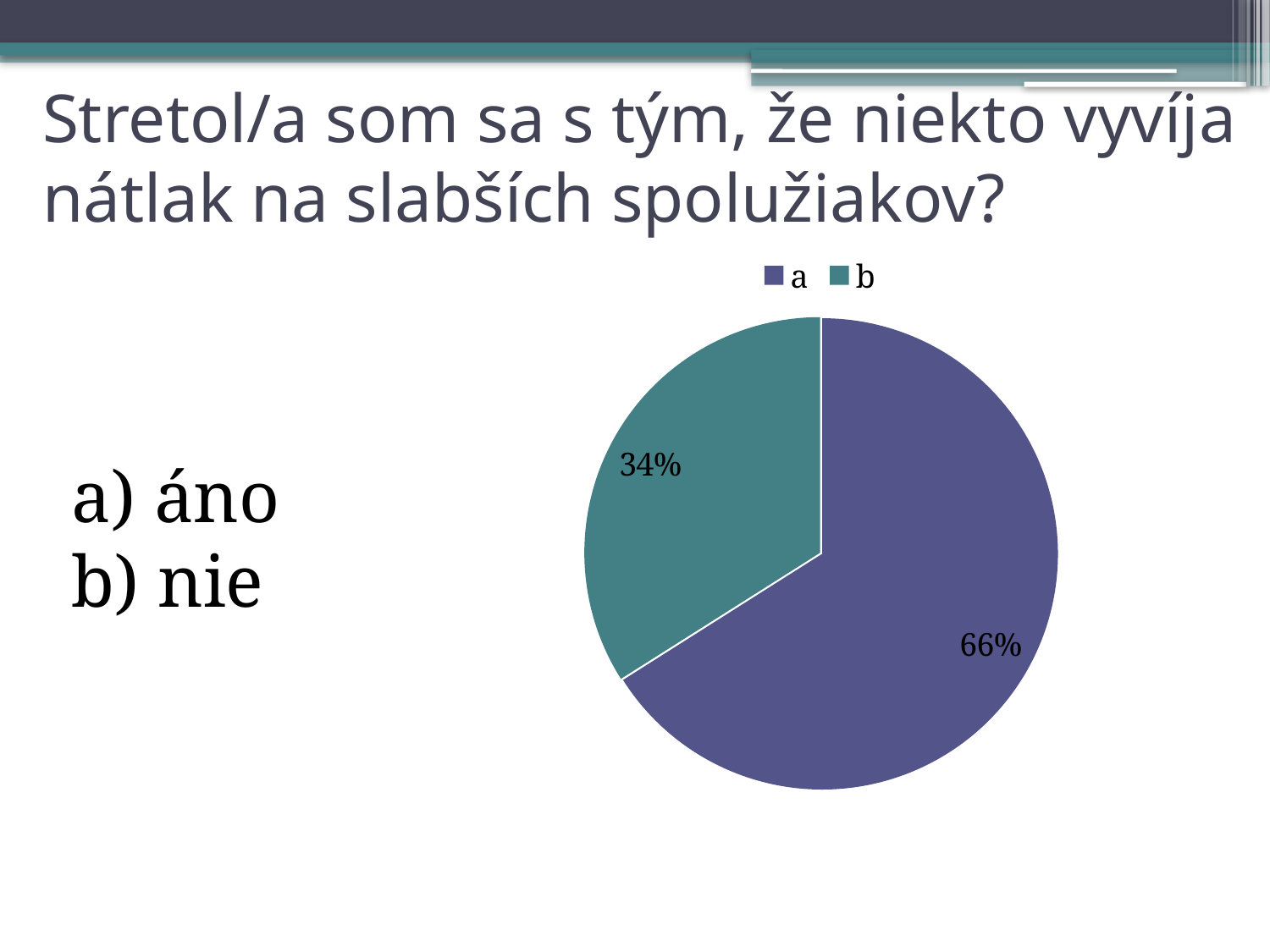
Which slice is the smallest? b Which is larger, the value for a or the value for b? a What is the value for slice b? 34% How many entries does the legend list? 2 What share of the pie does slice b represent? 34% What kind of chart is shown on the slide? pie chart Which answer option does legend entry b correspond to according to the slide text? nie Which slice is the largest? a What is the difference between the values for a and b? 32% What colour is the slice for a? purple What is the value for slice a? 66% How many slices does the pie chart have? 2